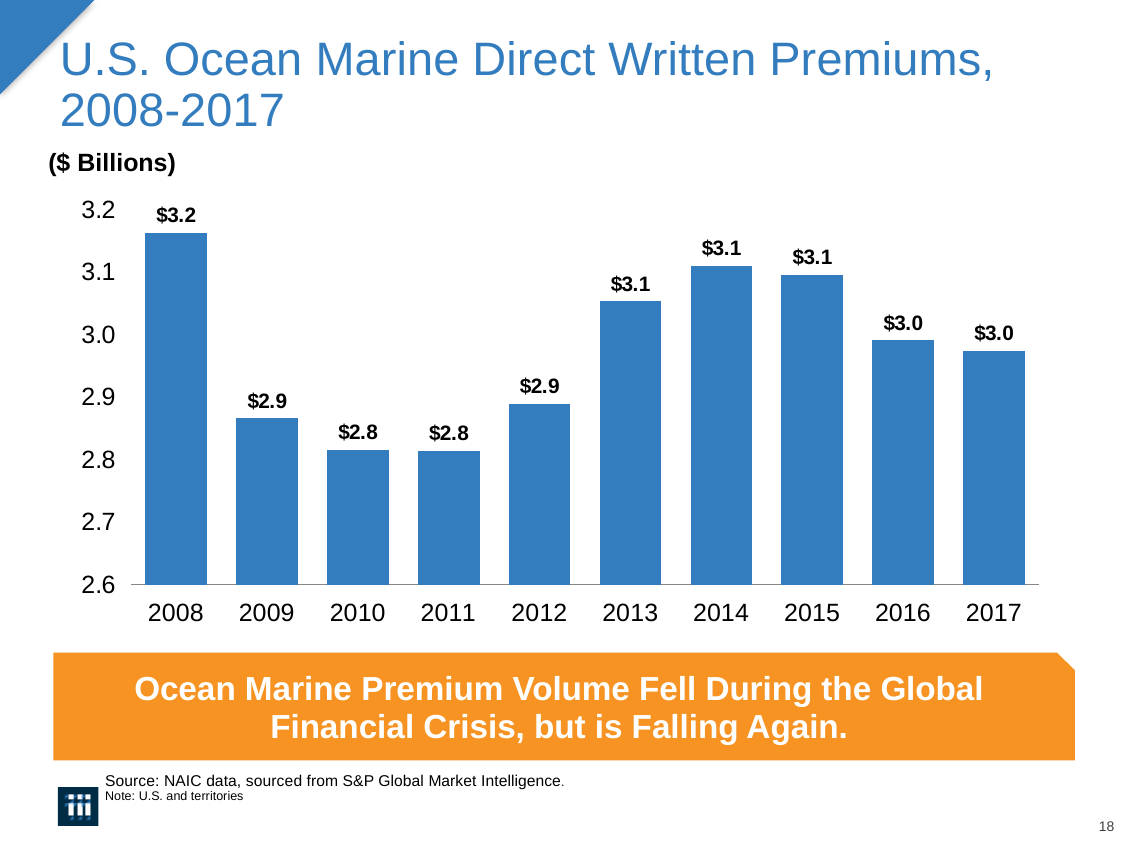
What unit is stated for the values in the chart? $ Billions Is the value for 2012 greater or less than 3.0? less Do the values rise or fall from 2008 to 2011? fall What value is shown for 2012? $2.9 What was the U.S. ocean marine direct written premium in 2008? $3.2 Which year has the highest direct written premiums? 2008 What value is shown for 2017? $3.0 Is the value for 2016 greater or less than 2.9? greater What kind of chart is shown on the slide? bar chart How many years are plotted in the chart? 10 Which is larger, the value for 2008 or the value for 2009? 2008 What is the difference between the 2008 value and the 2009 value, using the data labels? $0.3